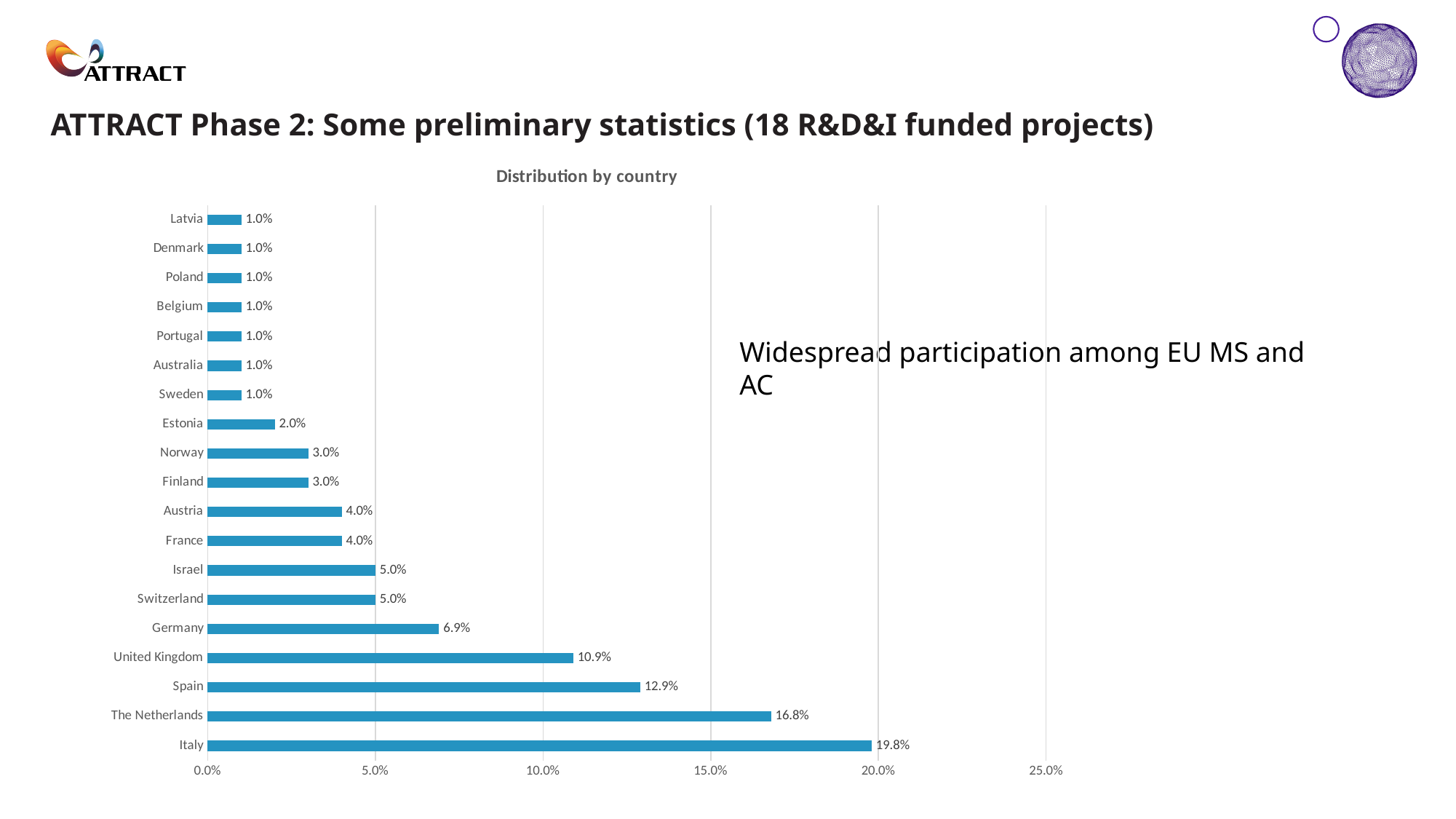
What is the value for Germany? 6.9% Which country has the highest value? Italy How many countries are shown in the chart? 19 What is the difference between the values for Italy and The Netherlands? 3.0% What is the value for Italy? 19.8% What is the value for Estonia? 2.0% Which is larger, the value for Spain or the value for Germany? Spain What is the value for the United Kingdom? 10.9% What is the difference between the values for Spain and the United Kingdom? 2.0% What kind of chart is shown on the slide? Bar chart What is the title of the chart? Distribution by country Is the value for The Netherlands greater or less than 15.0%? greater